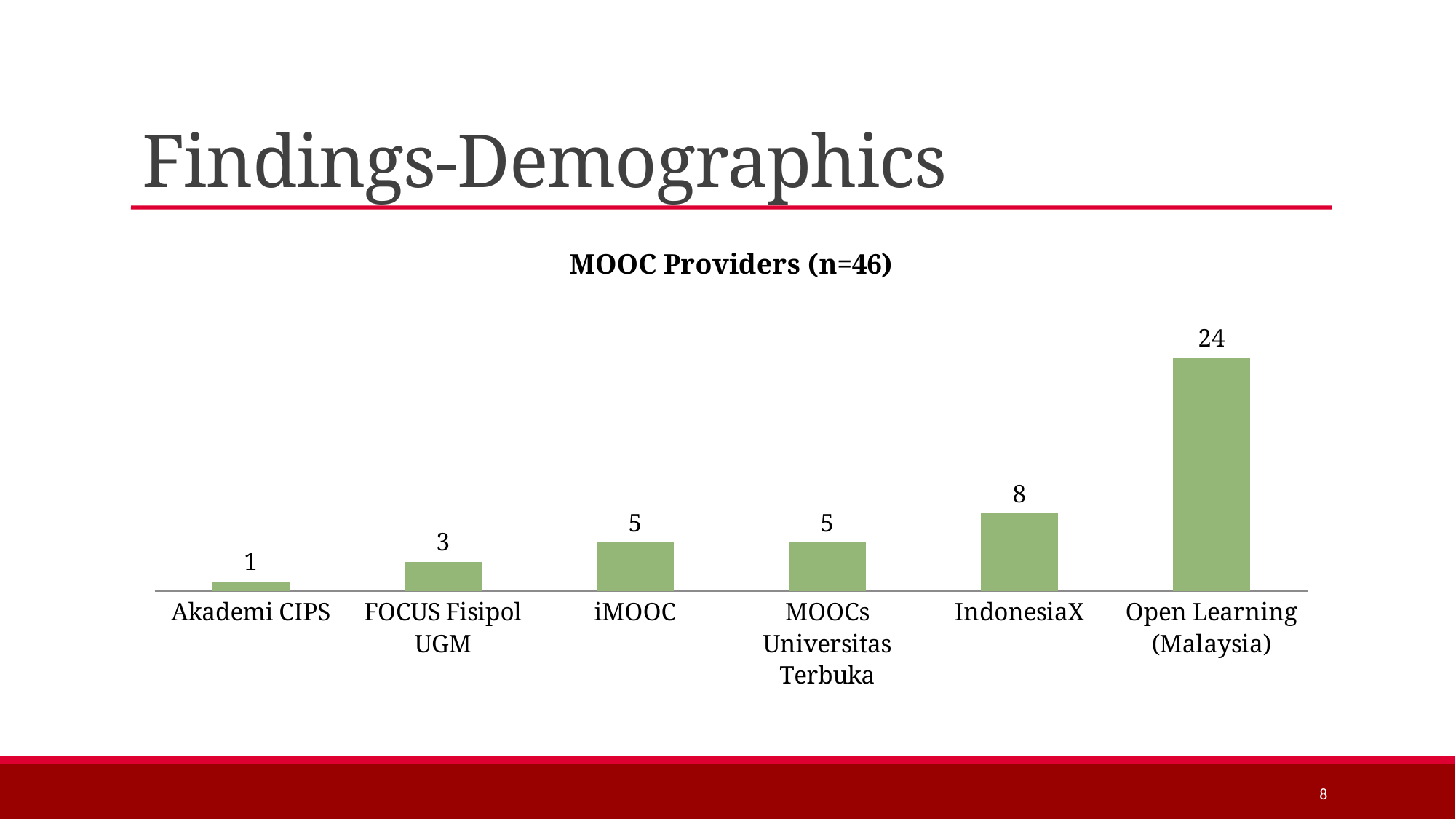
What is the value for IndonesiaX? 8 What is the value for Akademi CIPS? 1 How many MOOC providers are shown in the chart? 6 What is the value for FOCUS Fisipol UGM? 3 Which MOOC provider has the lowest value? Akademi CIPS What kind of chart is shown on the slide? Bar chart What is the value for Open Learning (Malaysia)? 24 What is the title of the chart? MOOC Providers (n=46) Do the values rise or fall from left to right along the x axis? Rise Which MOOC provider has the highest value? Open Learning (Malaysia) Which is larger, the value for iMOOC or the value for FOCUS Fisipol UGM? iMOOC What is the difference between the values for Open Learning (Malaysia) and IndonesiaX? 16